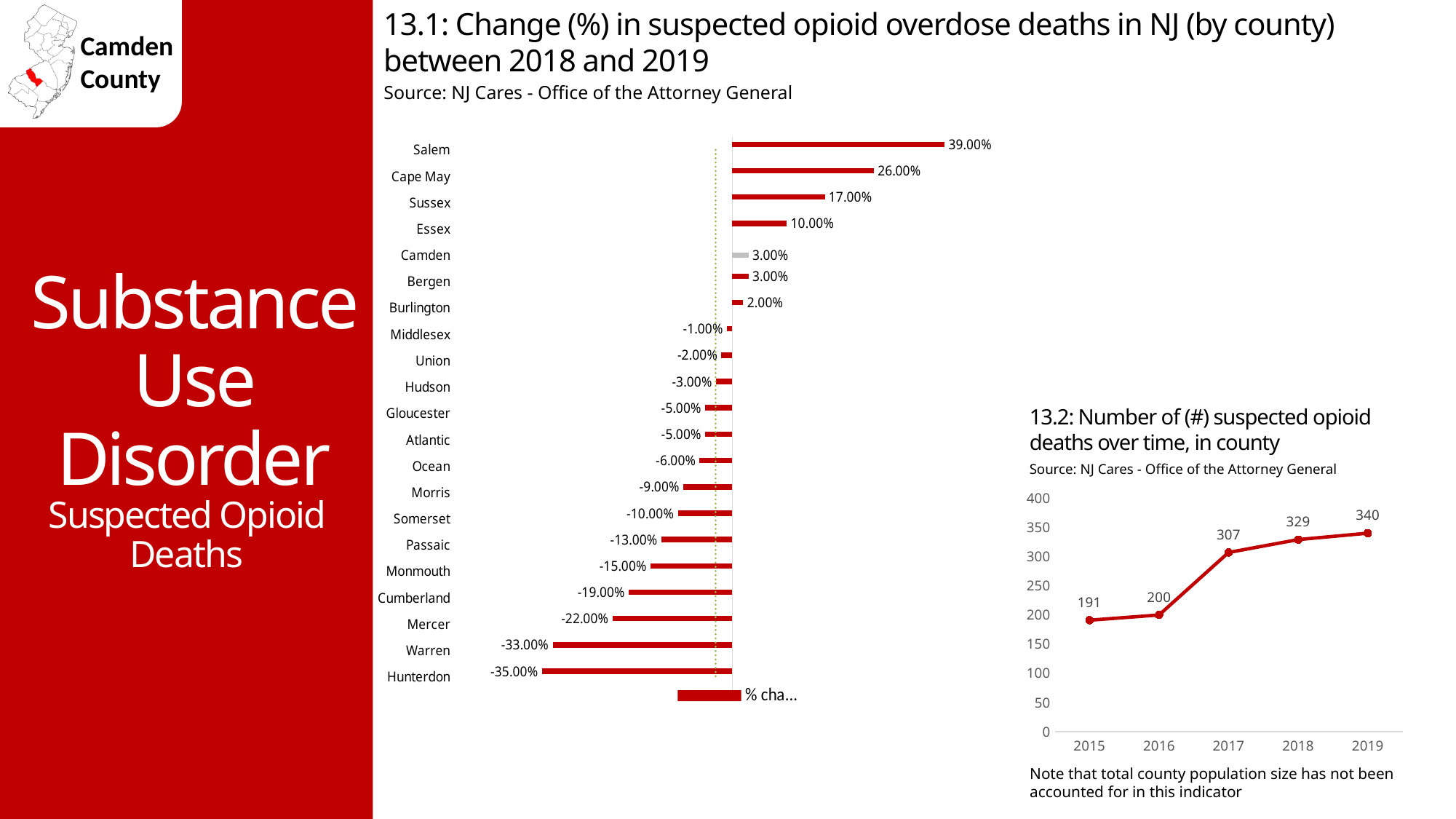
In chart 13.1, which county has the highest change (%)? Salem In chart 13.2, do the values rise or fall from 2015 to 2019? Rise In chart 13.1, how many counties are shown? 21 In chart 13.1, which county has the lowest change (%)? Hunterdon In chart 13.1, what is the change (%) for Cumberland? -19.00% In chart 13.1, which county has a larger change (%), Sussex or Essex? Sussex What kind of chart is chart 13.2? Line chart In chart 13.2, what is the difference in suspected opioid deaths between 2019 and 2015? 149 In chart 13.1, what is the change (%) in suspected opioid overdose deaths for Camden? 3.00% In chart 13.1, what is the difference between the values for Salem and Cape May? 13.00% What kind of chart is chart 13.1? Bar chart In chart 13.2, how many suspected opioid deaths were there in 2017? 307